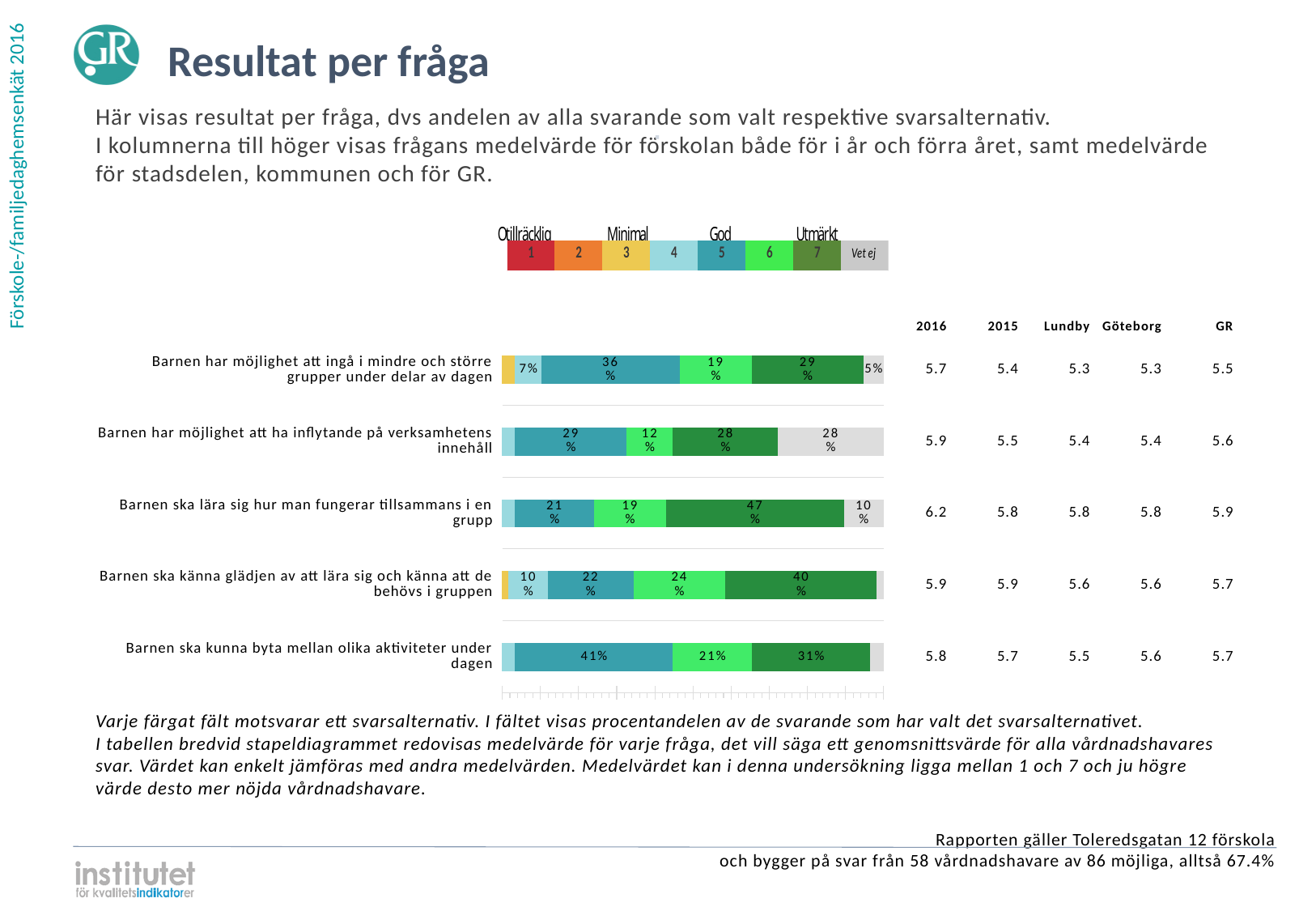
What label does the legend give to the grey category after 7? Vet ej What is the difference between the share choosing 7 and the share choosing 6 for 'Barnen ska känna glädjen av att lära sig och känna att de behövs i gruppen'? 16% For 'Barnen har möjlighet att ingå i mindre och större grupper under delar av dagen', which is larger: the share choosing 5 or the share choosing 7? 5 (36%) Which question has the smallest share of respondents choosing 6? Barnen har möjlighet att ha inflytande på verksamhetens innehåll Which question has the largest share of respondents choosing 7 (Utmärkt)? Barnen ska lära sig hur man fungerar tillsammans i en grupp What percentage of respondents chose 7 (Utmärkt) for 'Barnen ska lära sig hur man fungerar tillsammans i en grupp'? 47% What is the combined share of respondents choosing 5, 6 or 7 for 'Barnen ska kunna byta mellan olika aktiviteter under dagen'? 93% What kind of chart is shown on the slide? Stacked bar chart What percentage chose 5 for 'Barnen ska kunna byta mellan olika aktiviteter under dagen'? 41% What is the 'Vet ej' share for 'Barnen har möjlighet att ha inflytande på verksamhetens innehåll'? 28% How many questions (bars) are shown in the chart? 5 What is the 2016 mean value for 'Barnen ska lära sig hur man fungerar tillsammans i en grupp'? 6.2